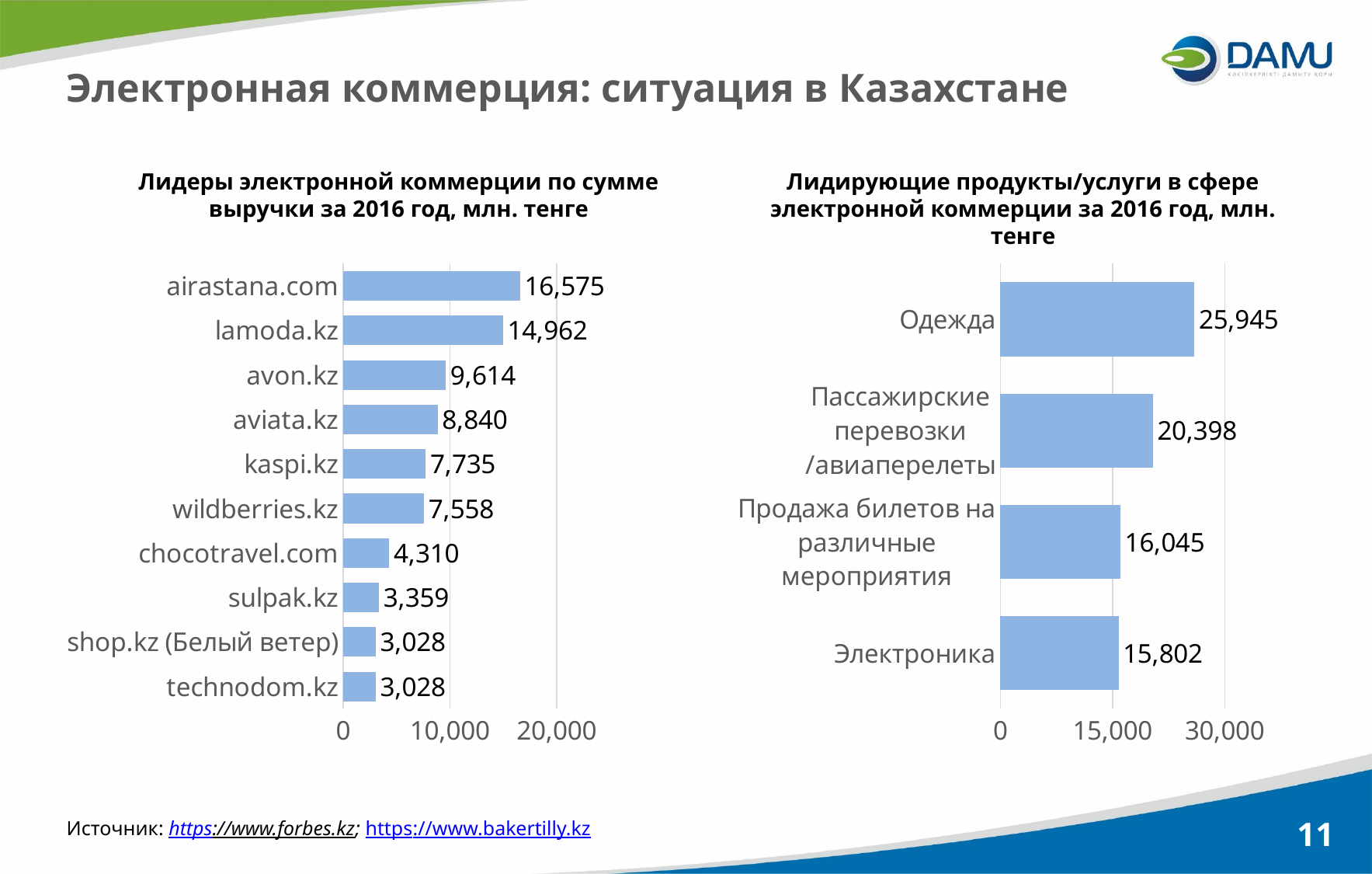
In the left chart (Лидеры электронной коммерции по сумме выручки за 2016 год), which is larger, avon.kz or aviata.kz? avon.kz In the right chart (Лидирующие продукты/услуги в сфере электронной коммерции за 2016 год), which category has the lowest value? Электроника In the right chart (Лидирующие продукты/услуги в сфере электронной коммерции за 2016 год), what is the value for Одежда? 25,945 In the left chart (Лидеры электронной коммерции по сумме выручки за 2016 год), what is the difference between airastana.com and lamoda.kz? 1,613 In the left chart (Лидеры электронной коммерции по сумме выручки за 2016 год), what is the value for lamoda.kz? 14,962 What kind of chart is the right chart (Лидирующие продукты/услуги в сфере электронной коммерции за 2016 год)? Bar chart In the left chart (Лидеры электронной коммерции по сумме выручки за 2016 год), what is the value for chocotravel.com? 4,310 In the right chart (Лидирующие продукты/услуги в сфере электронной коммерции за 2016 год), how many categories are shown? 4 In the left chart (Лидеры электронной коммерции по сумме выручки за 2016 год), which company has the highest revenue? airastana.com In the right chart (Лидирующие продукты/услуги в сфере электронной коммерции за 2016 год), is the value for Продажа билетов на различные мероприятия greater or less than 15,000? greater In the right chart (Лидирующие продукты/услуги в сфере электронной коммерции за 2016 год), what is the difference between Одежда and Пассажирские перевозки/авиаперелеты? 5,547 In the left chart (Лидеры электронной коммерции по сумме выручки за 2016 год), how many companies are shown? 10